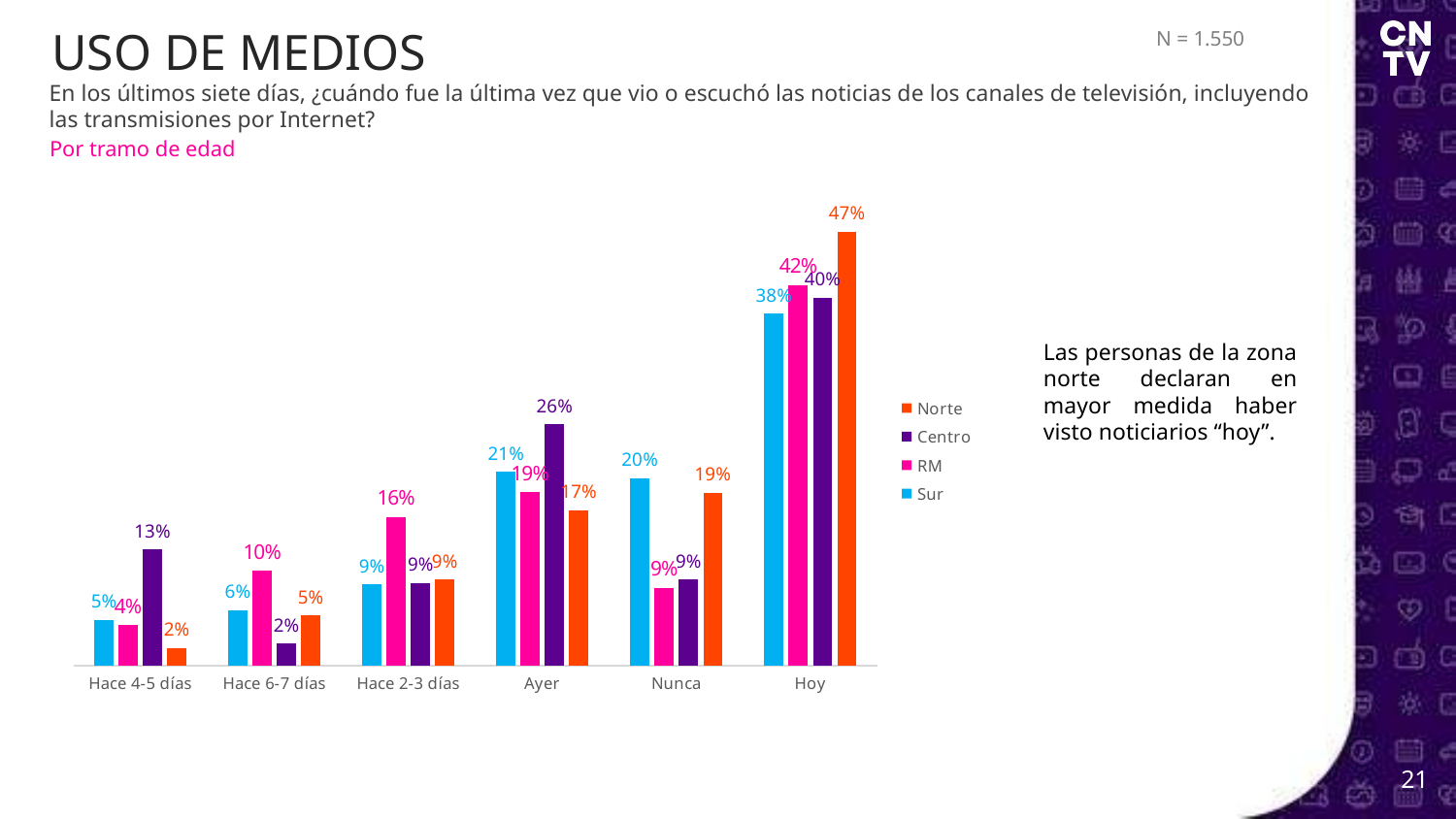
What is the value for RM in the Hace 2-3 días category? 16% Which is larger in the Ayer category, Sur or RM? Sur What is the value for Sur in the Nunca category? 20% What is the value for Norte in the Hoy category? 47% Which series has the highest value in the Hoy category? Norte What is the difference between Norte and Sur in the Hoy category? 9% What is the value for Centro in the Ayer category? 26% What kind of chart is shown on the slide? Bar chart How many categories are shown on the x axis? 6 What is the sample size (N) shown on the slide? 1.550 How many series does the legend list? 4 Which series has the lowest value in the Hace 6-7 días category? Centro